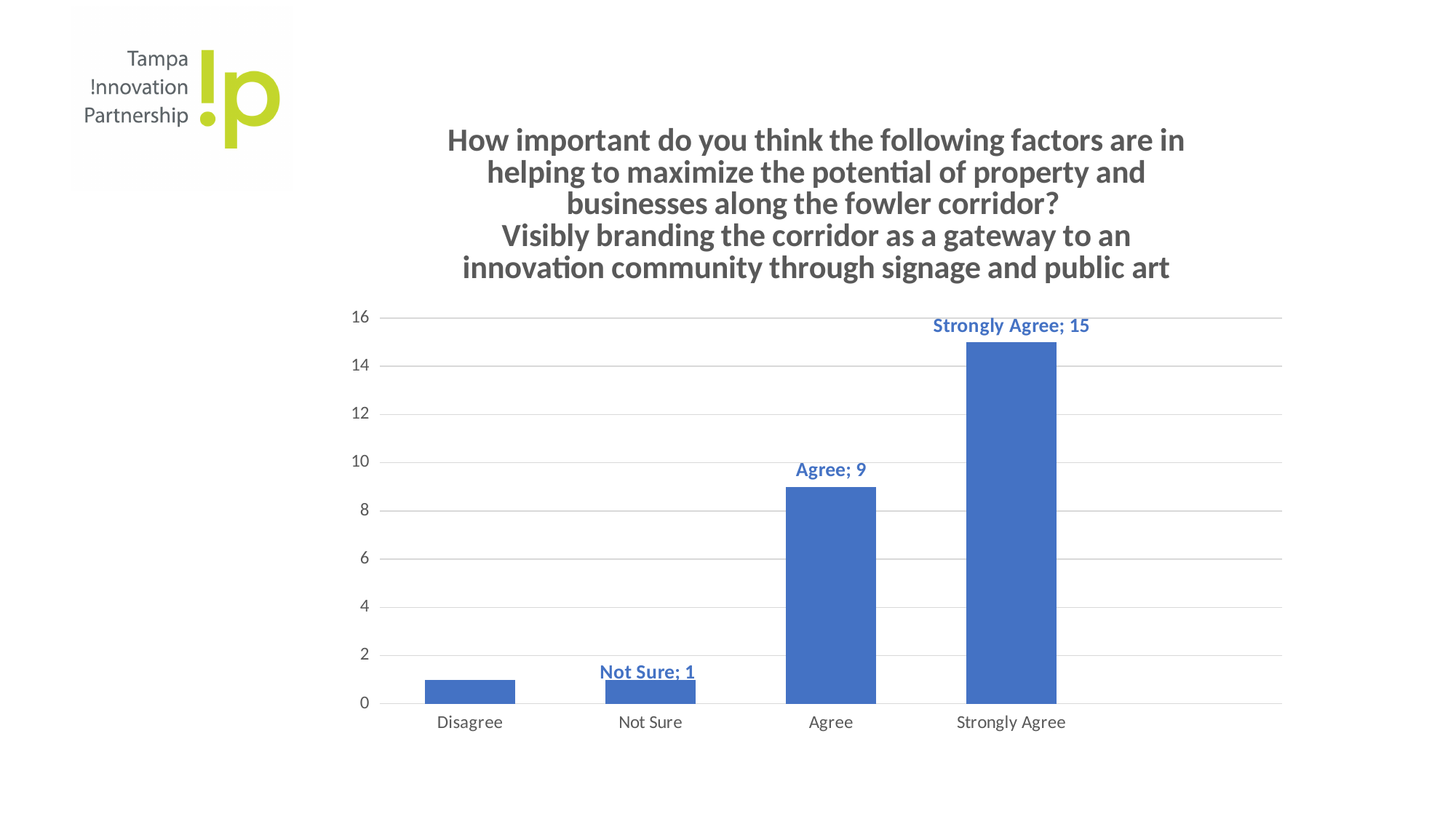
What is the value for Not Sure? 1 What is the value for Strongly Agree? 15 What colour are the bars in the chart? blue Which category has the highest value? Strongly Agree Is the value for Strongly Agree greater or less than 14? greater What is the difference between the values for Agree and Not Sure? 8 What is the value for Agree? 9 Is the value for Disagree greater or less than 2? less Which is larger, the value for Agree or the value for Strongly Agree? Strongly Agree What is the difference between the values for Strongly Agree and Agree? 6 How many categories are shown on the x axis? 4 What kind of chart is shown on the slide? bar chart